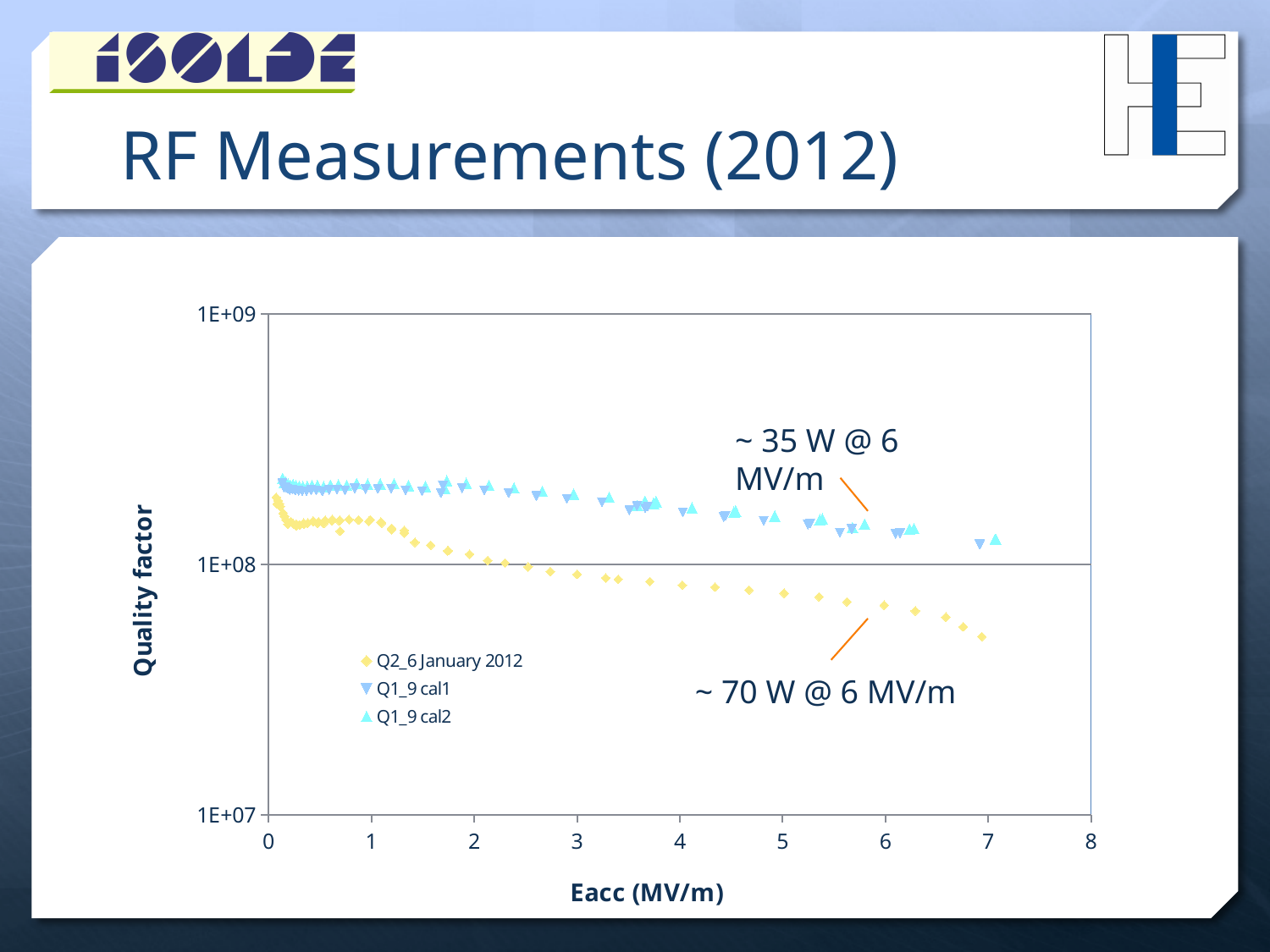
At Eacc = 4 MV/m, which series has the higher quality factor, Q2_6 January 2012 or Q1_9 cal1? Q1_9 cal1 Is the quality factor for Q1_9 cal1 at Eacc = 6 MV/m greater or less than 1E+08? greater Is the quality factor for Q2_6 January 2012 at Eacc = 6 MV/m greater or less than 1E+08? less What kind of chart is shown on the slide? scatter chart Is the quality factor for Q2_6 January 2012 at Eacc = 4 MV/m greater or less than 1E+08? less Does the quality factor for Q1_9 cal2 rise or fall as Eacc increases from 1 to 7 MV/m? fall What is the label of the y axis? Quality factor Does the quality factor for Q2_6 January 2012 rise or fall as Eacc increases? fall How many series does the chart legend list? 3 What is the label of the x axis? Eacc (MV/m)